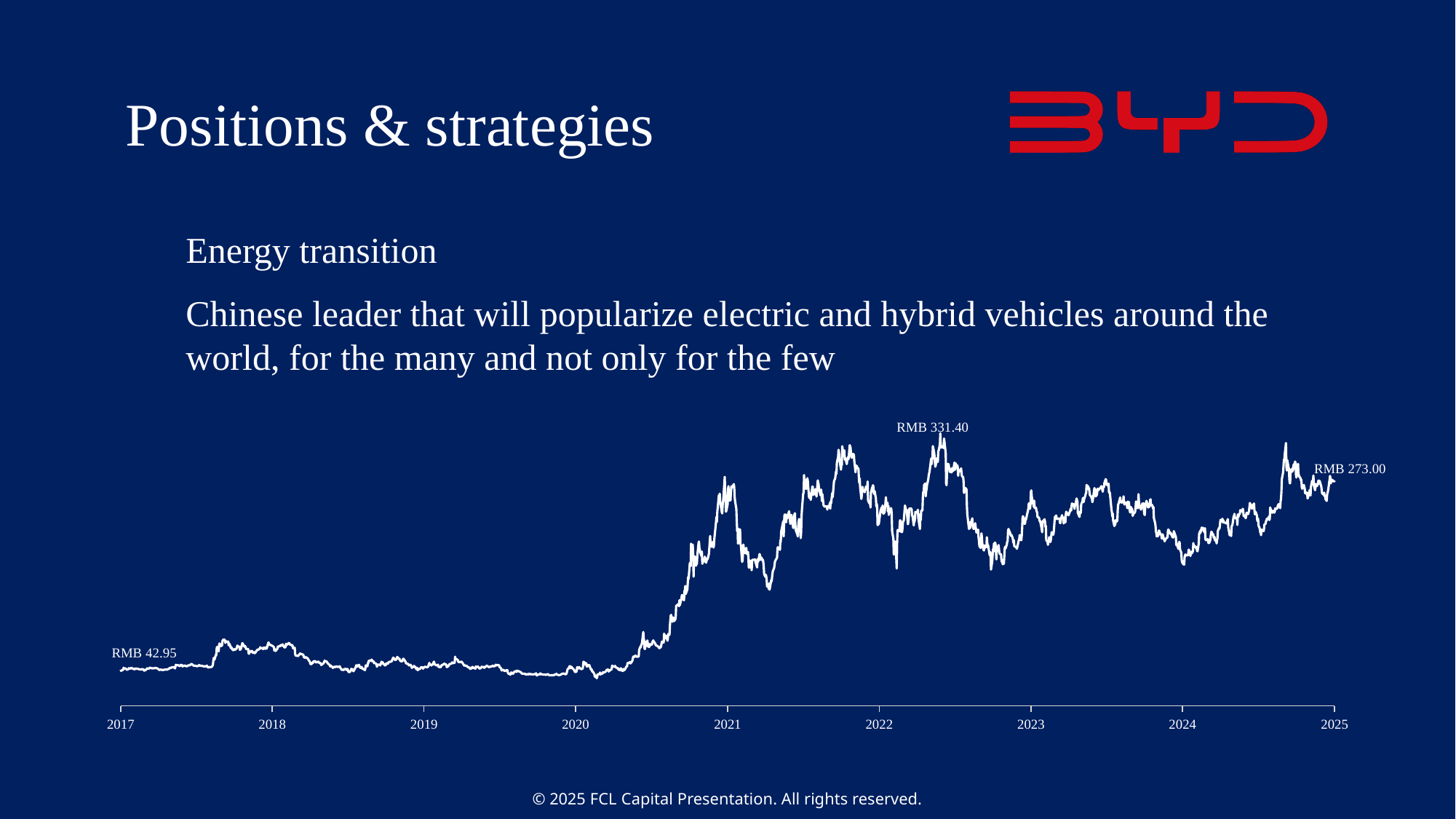
In which year does the line reach its labelled peak of RMB 331.40? 2022 Which of the three labelled values on the chart is the lowest? RMB 42.95 What is the difference between the labelled peak value and the labelled end value? RMB 58.40 Which of the three labelled values on the chart is the highest? RMB 331.40 How many year labels are shown on the x axis? 9 What is the difference between the labelled end value in 2025 and the labelled start value in 2017? RMB 230.05 Is the labelled value at the end of the line larger or smaller than the labelled value at the start? larger What kind of chart is shown on the slide? line chart Overall, does the line rise or fall from 2017 to 2025? rise What is the labelled value at the start of the line in 2017? RMB 42.95 What is the labelled peak value of the line? RMB 331.40 What is the labelled value at the end of the line in 2025? RMB 273.00